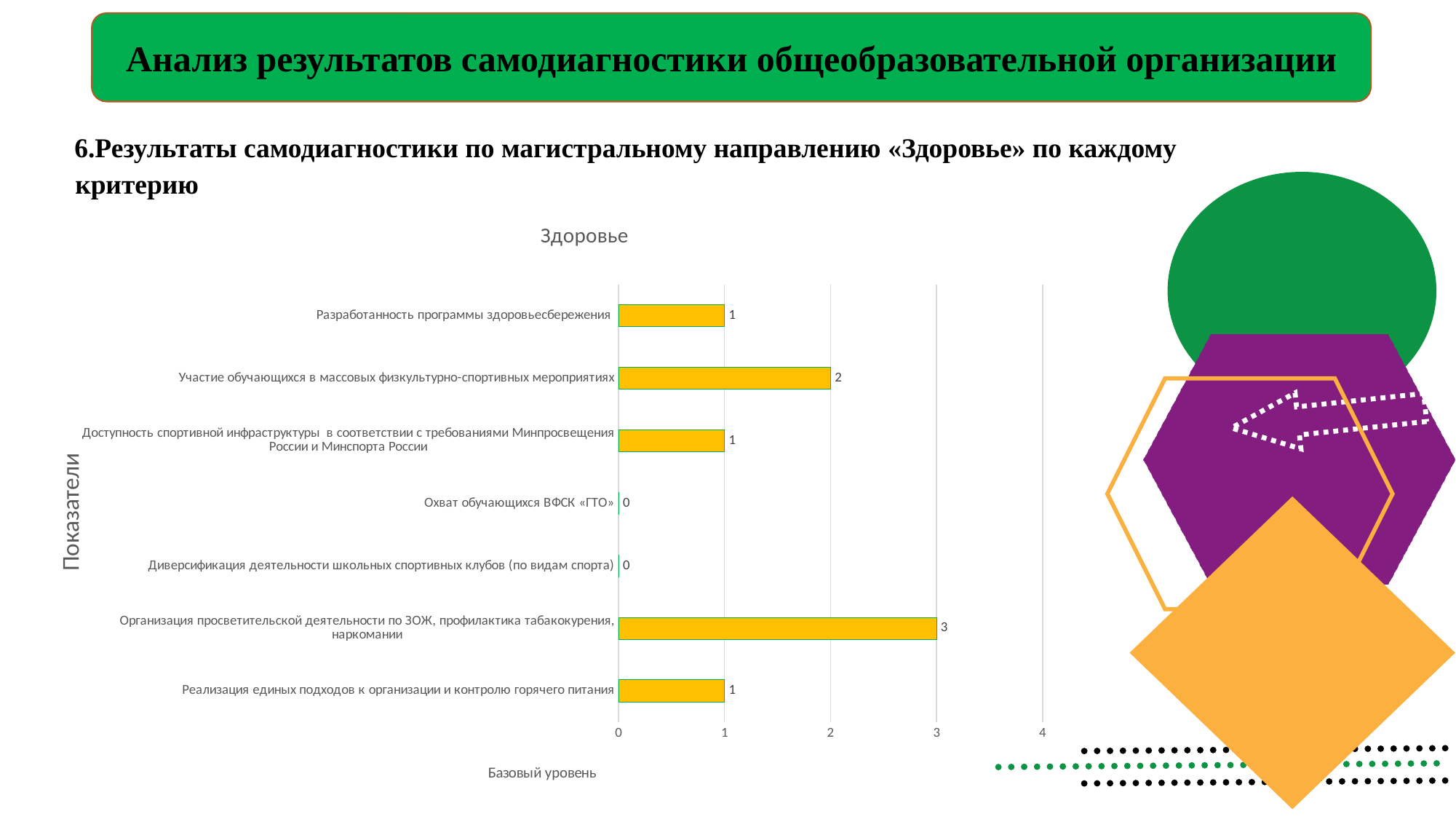
What is the value for «Охват обучающихся ВФСК «ГТО»»? 0 What is the value for «Участие обучающихся в массовых физкультурно-спортивных мероприятиях»? 2 Which is larger: the value for «Участие обучающихся в массовых физкультурно-спортивных мероприятиях» or the value for «Доступность спортивной инфраструктуры в соответствии с требованиями Минпросвещения России и Минспорта России»? Участие обучающихся в массовых физкультурно-спортивных мероприятиях What is the value for «Реализация единых подходов к организации и контролю горячего питания»? 1 What is the value for «Организация просветительской деятельности по ЗОЖ, профилактика табакокурения, наркомании»? 3 What is the difference between the values for «Организация просветительской деятельности по ЗОЖ, профилактика табакокурения, наркомании» and «Разработанность программы здоровьесбережения»? 2 What is the title of the chart? Здоровье Which category has the highest value? Организация просветительской деятельности по ЗОЖ, профилактика табакокурения, наркомании What type of chart is shown on the slide? bar chart How many categories are shown in the chart? 7